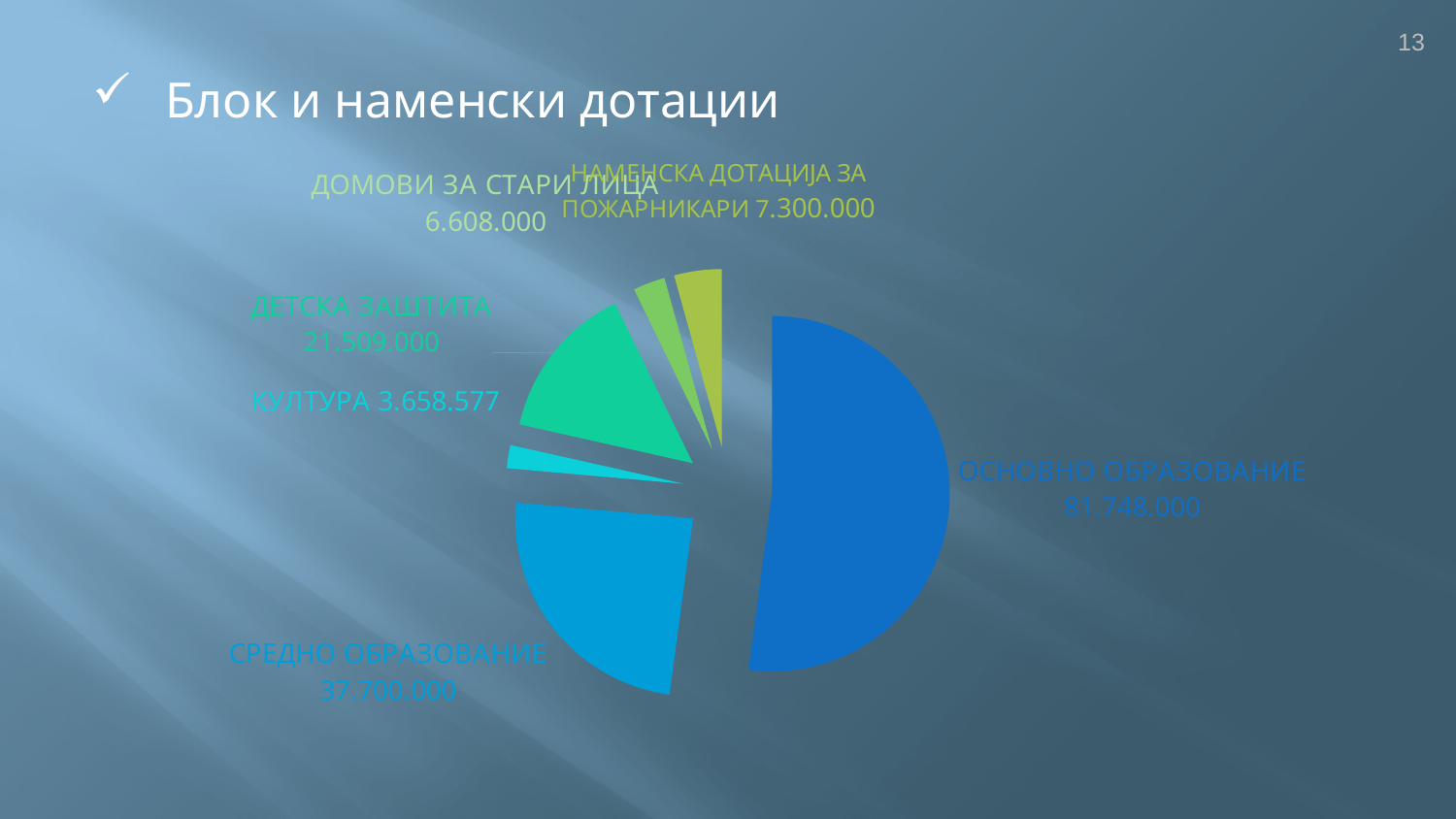
What is the value for СРЕДНО ОБРАЗОВАНИЕ? 37.700.000 What kind of chart is shown on the slide? pie chart What is the value for ДЕТСКА ЗАШТИТА? 21.509.000 What is the value for ОСНОВНО ОБРАЗОВАНИЕ? 81.748.000 What is the difference between the values for ОСНОВНО ОБРАЗОВАНИЕ and СРЕДНО ОБРАЗОВАНИЕ? 44.048.000 What is the value for КУЛТУРА? 3.658.577 How many slices does the pie chart have? 6 What is the title of the slide containing the pie chart? Блок и наменски дотации Which category has the smallest slice of the pie? КУЛТУРА What is the value for НАМЕНСКА ДОТАЦИЈА ЗА ПОЖАРНИКАРИ? 7.300.000 Which category has the largest slice of the pie? ОСНОВНО ОБРАЗОВАНИЕ Which is larger, ДЕТСКА ЗАШТИТА or ДОМОВИ ЗА СТАРИ ЛИЦА? ДЕТСКА ЗАШТИТА